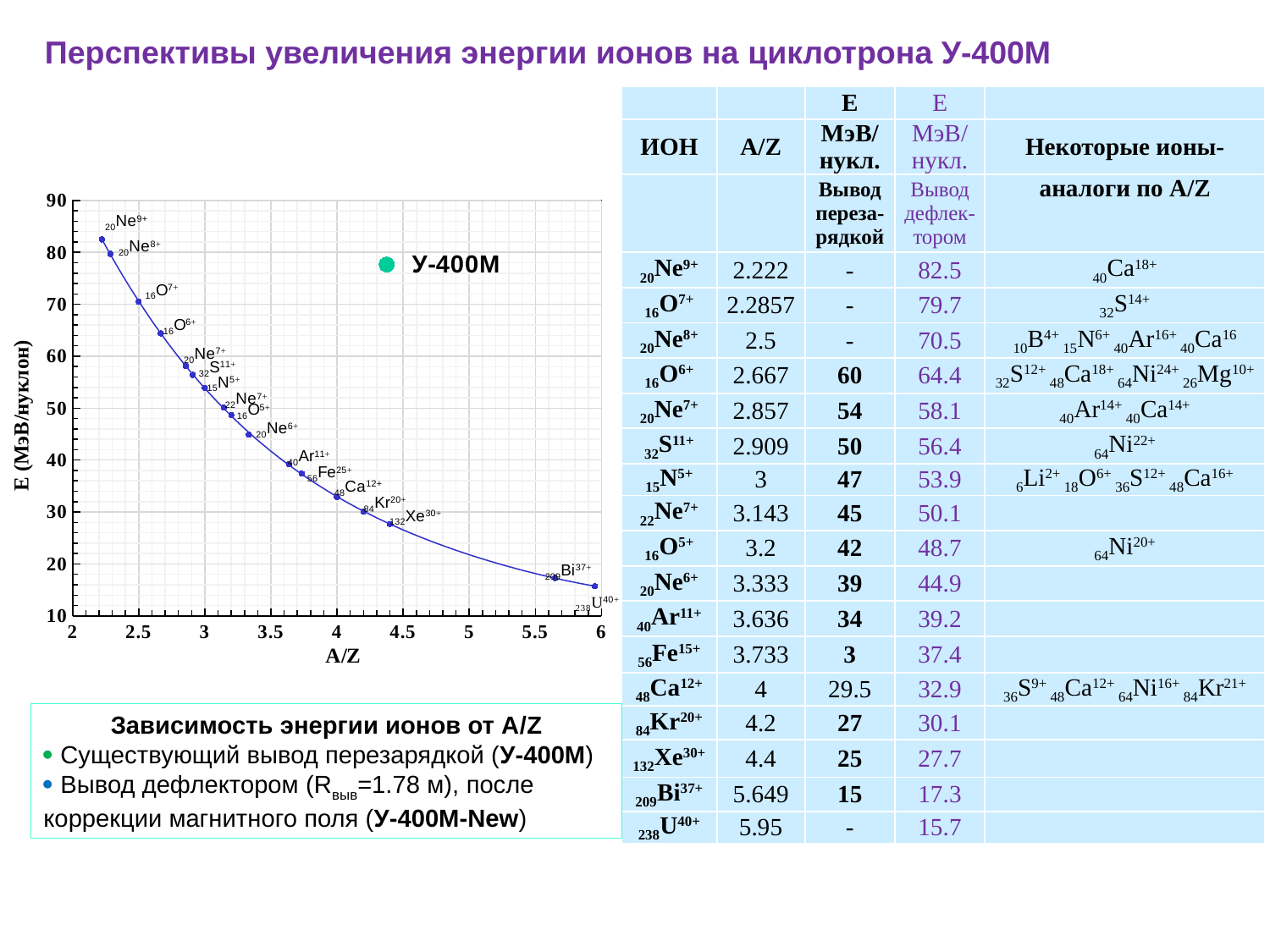
In the chart, does the energy E rise or fall as A/Z increases? fall In the chart, is the value for 209Bi37+ greater or less than 20? less What kind of chart is shown on the left of the slide? line chart In the chart, which ion has the highest energy E? 20Ne9+ What is the label of the x axis of the chart? A/Z In the chart, is the value for 16O6+ greater or less than 60? greater How many ion data points are plotted on the chart? 17 In the chart, which ion has the lowest energy E? 238U40+ In the chart, is the value for 20Ne6+ greater or less than 50? less How many series does the chart legend list? 1 In the chart, which has the higher energy E: 32S11+ or 48Ca12+? 32S11+